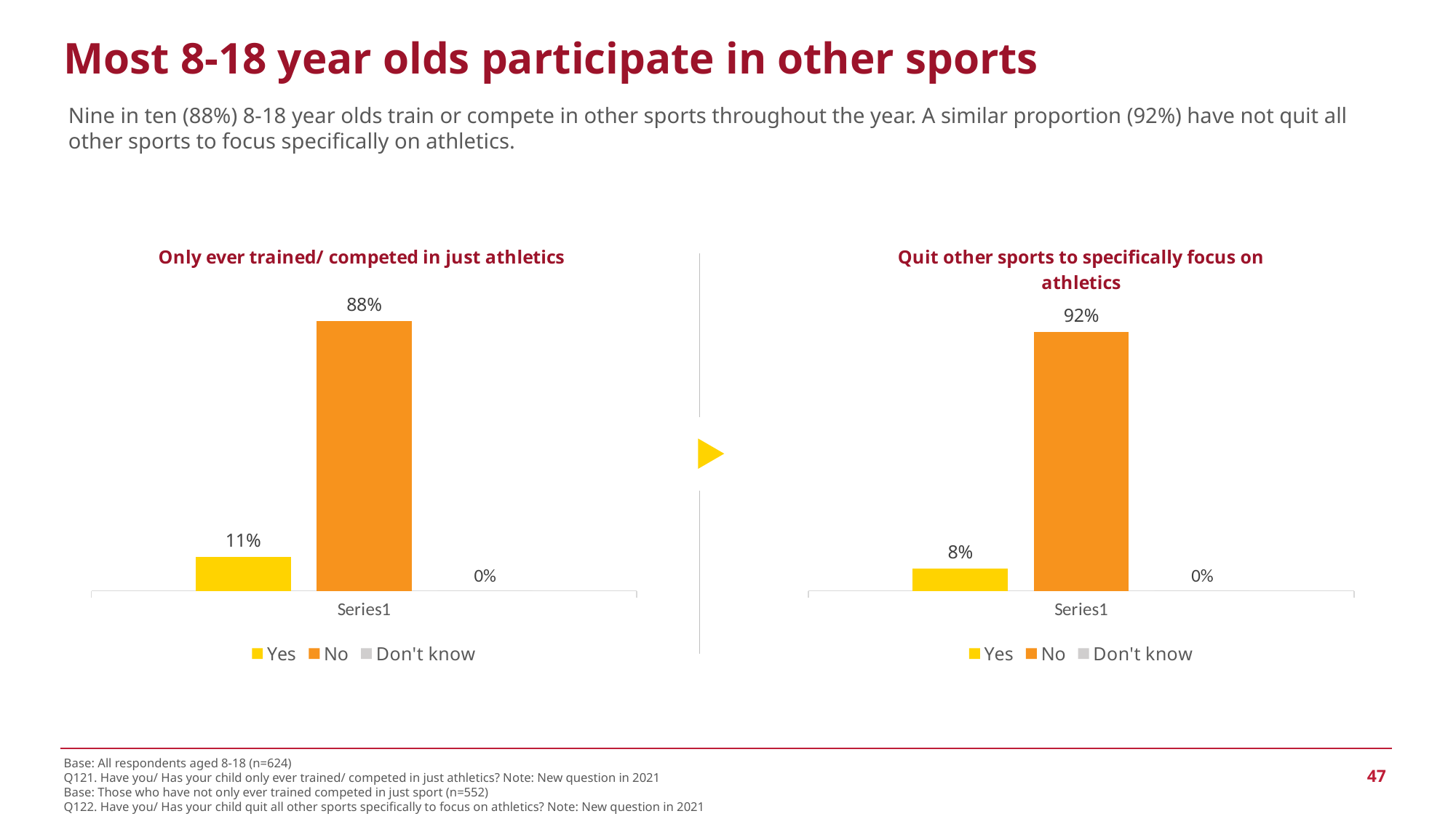
In the 'Quit other sports to specifically focus on athletics' chart, which series has the lowest value? Don't know How many series does the legend of the 'Only ever trained/ competed in just athletics' chart list? 3 In the 'Only ever trained/ competed in just athletics' chart, which series has the highest value? No In the 'Quit other sports to specifically focus on athletics' chart, what is the value for No? 92% In the 'Quit other sports to specifically focus on athletics' chart, what is the value for Yes? 8% Which is larger: the Yes value in the 'Only ever trained/ competed in just athletics' chart or the Yes value in the 'Quit other sports to specifically focus on athletics' chart? Only ever trained/ competed in just athletics In the 'Only ever trained/ competed in just athletics' chart, what is the difference between the No and Yes values? 77% In the 'Quit other sports to specifically focus on athletics' chart, what is the difference between the No and Yes values? 84% In the 'Quit other sports to specifically focus on athletics' chart, what is the value for Don't know? 0% In the 'Only ever trained/ competed in just athletics' chart, what is the value for No? 88% In the 'Only ever trained/ competed in just athletics' chart, what is the value for Yes? 11% What kind of chart is the 'Quit other sports to specifically focus on athletics' chart? Bar chart